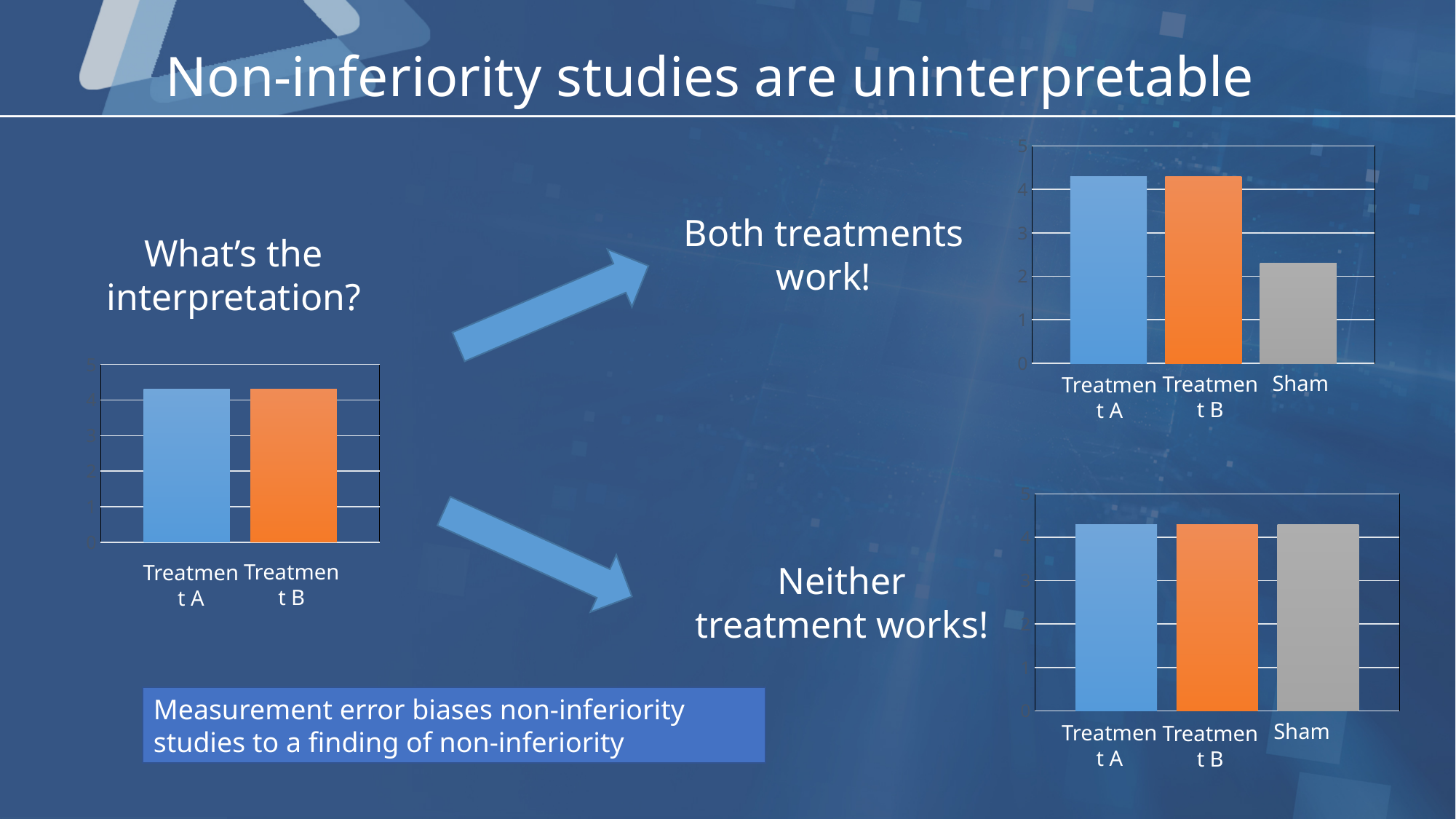
In the top-right chart, is the value for Sham greater or less than 2? greater How many categories does the top-right chart show? 3 In the top-right chart, which is larger, Treatment B or Sham? Treatment B In the top-right chart, is the value for Treatment A greater or less than 4? greater In the top-right chart, is the value for Sham greater or less than 3? less In the top-right chart, which category has the lowest value? Sham What kind of chart is the top-right chart? bar chart How many charts are on the slide? 3 What are the category labels on the bottom-right chart? Treatment A, Treatment B, Sham How many categories does the left chart show? 2 What colour is the Sham bar in the bottom-right chart? grey